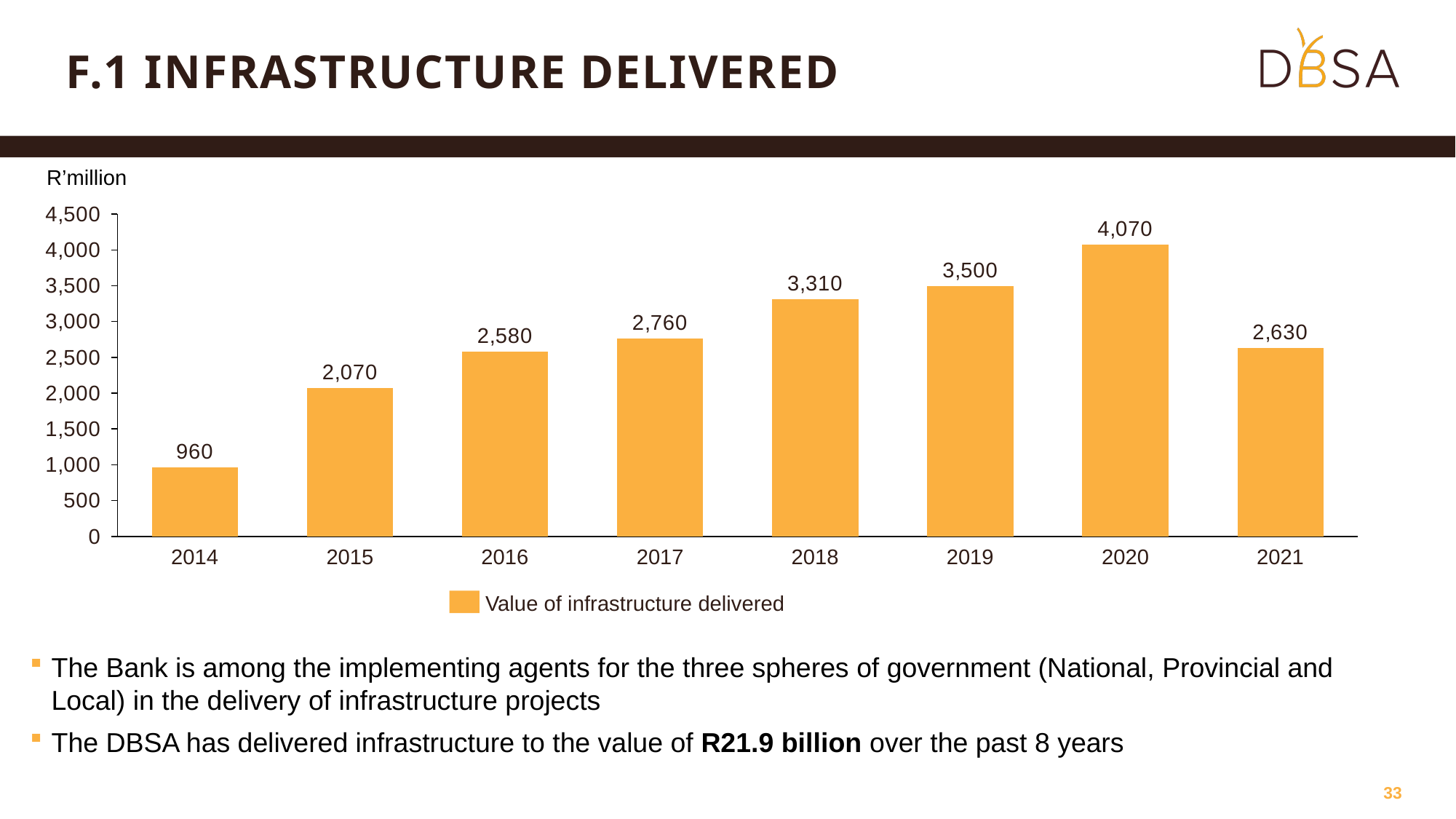
What is the value of infrastructure delivered in 2014? 960 Which year has the highest value of infrastructure delivered? 2020 Which year has a larger value of infrastructure delivered, 2016 or 2017? 2017 What kind of chart is shown on the slide? Bar chart What is the difference between the value of infrastructure delivered in 2020 and in 2021? 1,440 What is the value of infrastructure delivered in 2018? 3,310 What is the value of infrastructure delivered in 2021? 2,630 How many series does the chart legend list? 1 How many years are shown on the x axis of the chart? 8 What unit is shown above the y axis of the chart? R'million Is the value of infrastructure delivered in 2019 greater or less than 3,000? greater Which year has the lowest value of infrastructure delivered? 2014